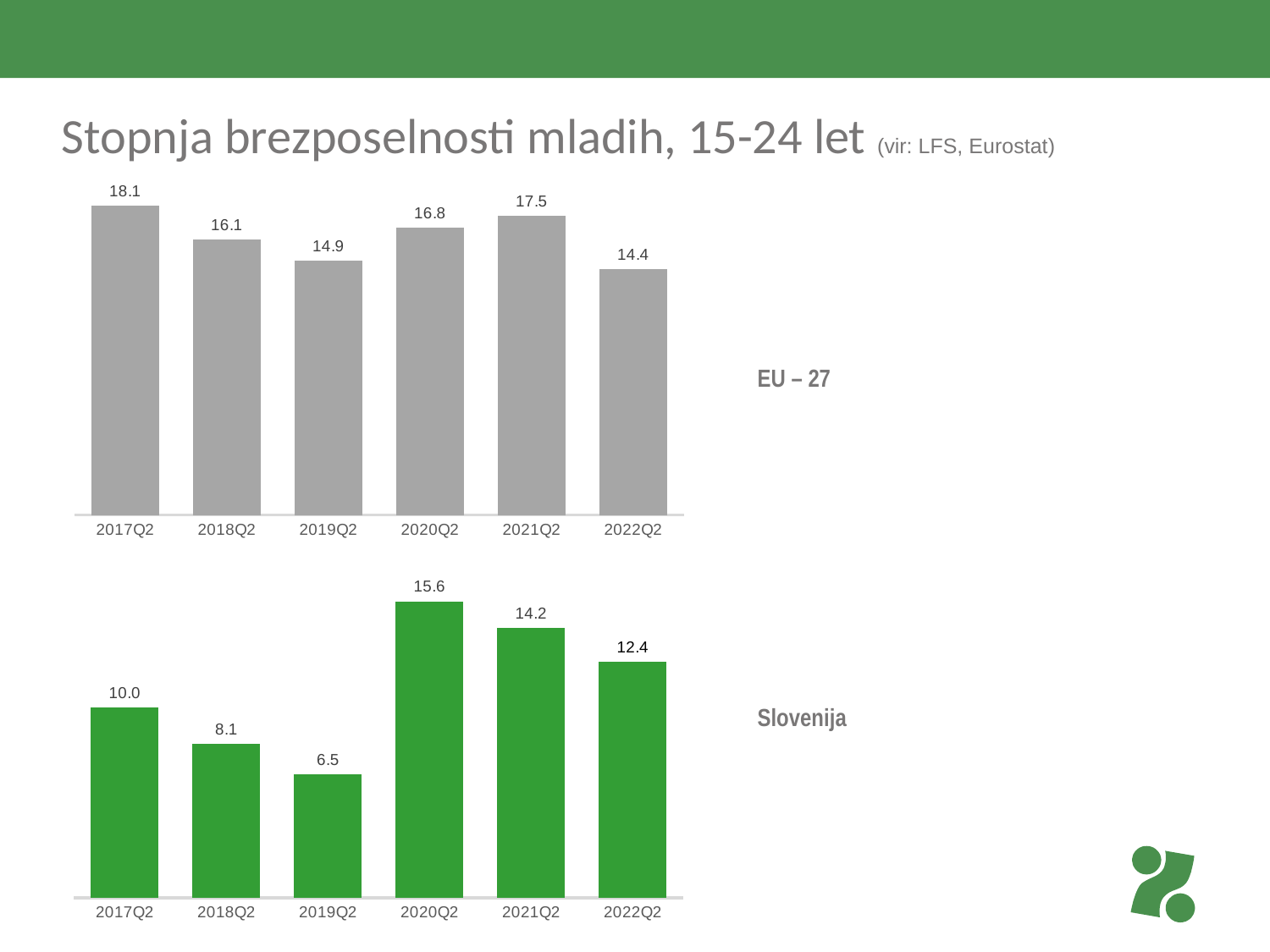
How many quarters are shown in the Slovenija chart (bottom)? 6 In the Slovenija chart (bottom), which quarter has the lowest value? 2019Q2 In the Slovenija chart (bottom), do the values rise or fall from 2020Q2 to 2022Q2? Fall In the EU – 27 chart (top), which quarter has the lowest value? 2022Q2 In the Slovenija chart (bottom), which is larger, the value for 2017Q2 or 2018Q2? 2017Q2 In the Slovenija chart (bottom), what is the difference between the values for 2020Q2 and 2019Q2? 9.1 What kind of chart is the EU – 27 chart (top)? Bar chart In the Slovenija chart (bottom), what is the value for 2020Q2? 15.6 In the EU – 27 chart (top), what is the difference between the values for 2017Q2 and 2022Q2? 3.7 In the EU – 27 chart (top), which is larger, the value for 2020Q2 or 2021Q2? 2021Q2 In the Slovenija chart (bottom), which quarter has the highest value? 2020Q2 In the EU – 27 chart (top), what is the value for 2017Q2? 18.1